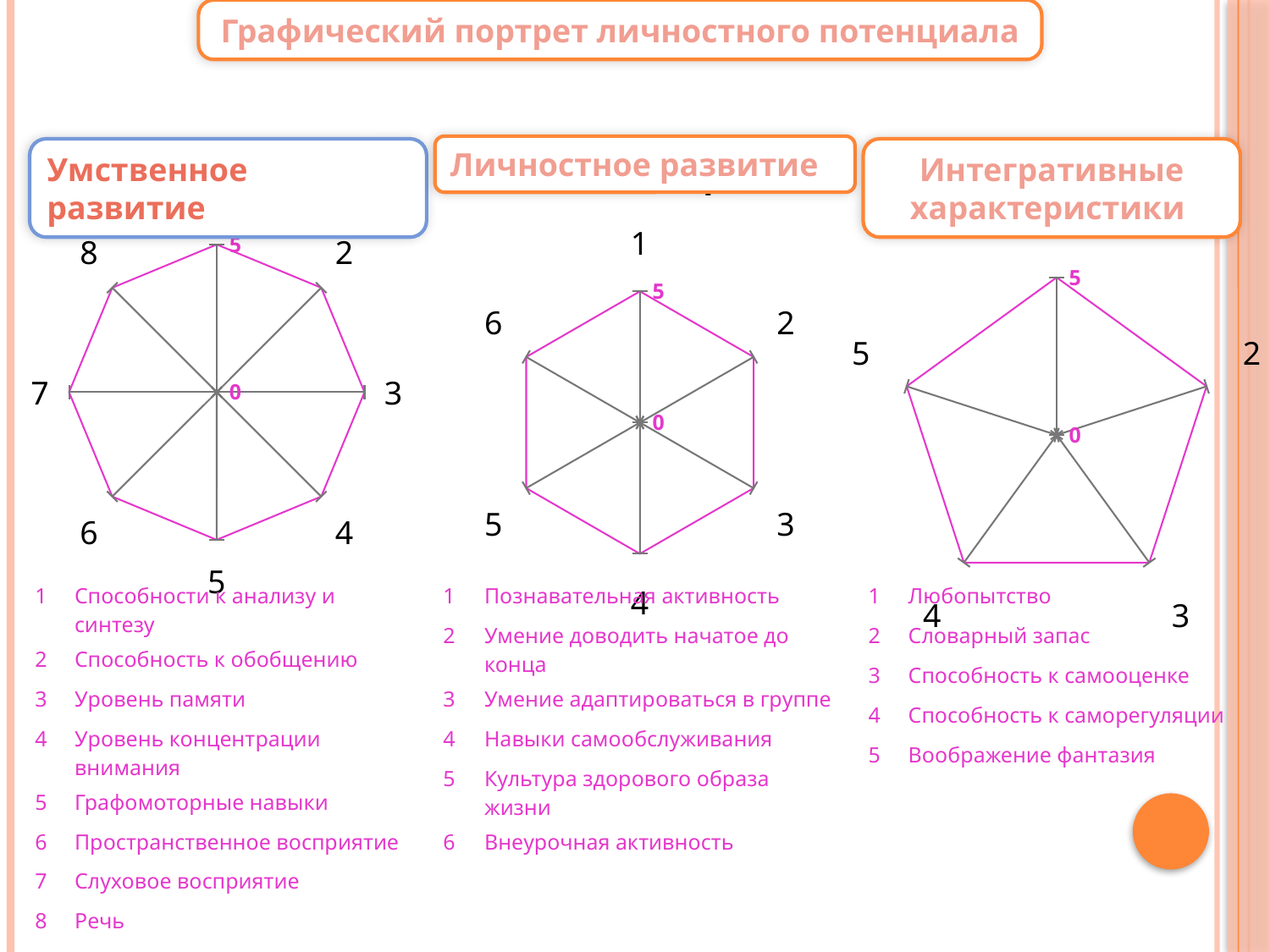
What kind of chart is used under the heading "Умственное развитие"? radar chart In the "Личностное развитие" chart, what value does the plotted line reach on axis 1 (the top axis)? 5 How many axes (categories) does the "Личностное развитие" radar chart have? 6 What is the title of the slide? Графический портрет личностного потенциала In the "Умственное развитие" chart, what value does the plotted line reach on axis 1 (the top axis)? 5 In the "Умственное развитие" chart, what is the maximum value marked on the axis scale? 5 How many axes (categories) does the "Умственное развитие" radar chart have? 8 In the "Личностное развитие" chart, what value is marked at the centre of the radar? 0 In the "Интегративные характеристики" chart, what value does the plotted line reach on axis 1 (the top axis)? 5 How many axes (categories) does the "Интегративные характеристики" radar chart have? 5